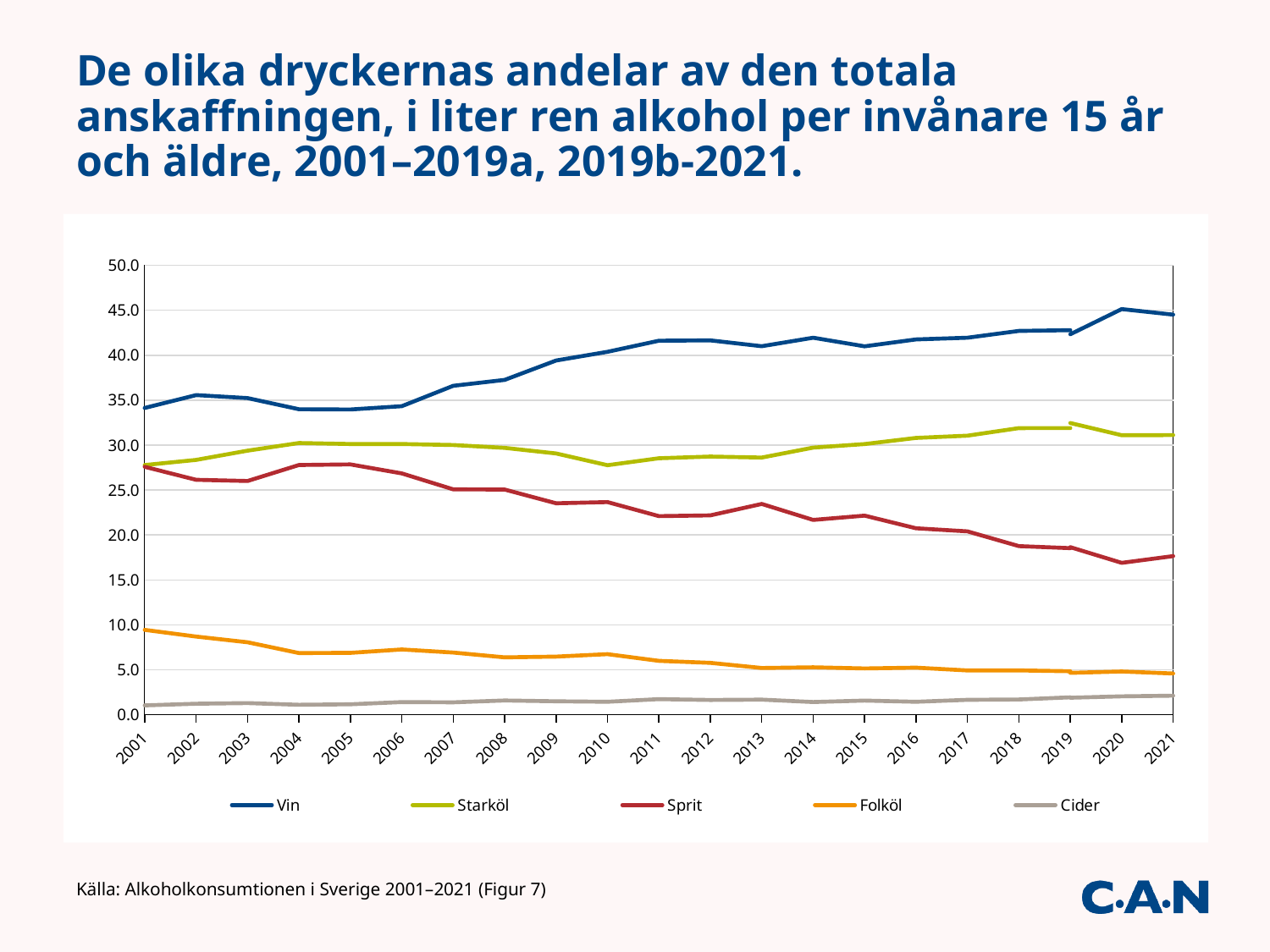
What kind of chart is shown on the slide? Line chart Which series has the lowest value across the whole period? Cider Does the Sprit line rise or fall from 2001 to 2021? Fall How many series does the legend list? 5 How many years are labelled on the x axis? 21 Which series is plotted with the orange line? Folköl Is the value for Starköl in 2010 greater or less than 30.0? less Is the value for Folköl in 2001 greater or less than 5.0? greater Is the value for Vin in 2001 greater or less than 30.0? greater Which series has the highest value in 2021? Vin Which is larger in 2001, Sprit or Folköl? Sprit